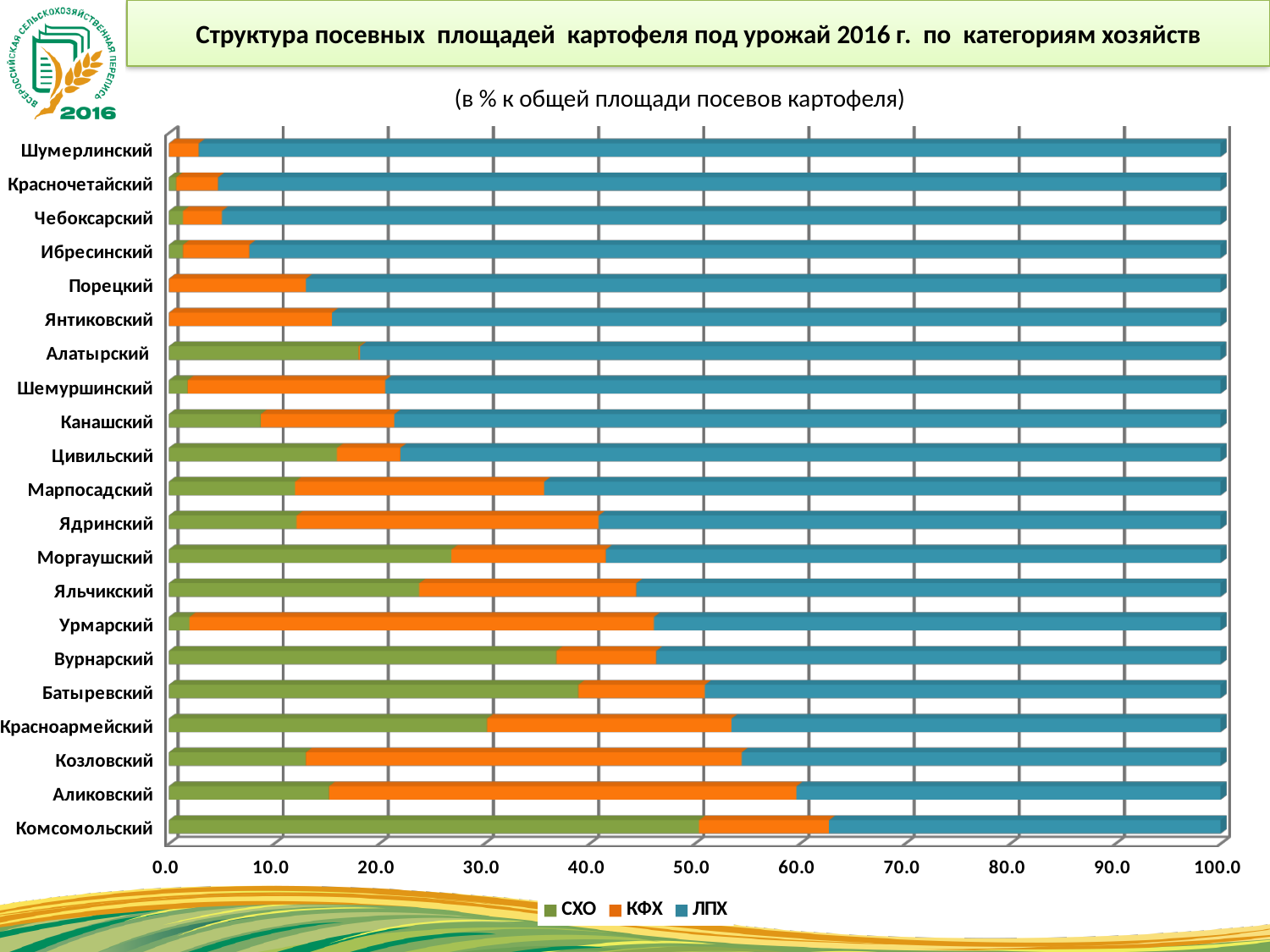
Which district has the largest СХО share? Комсомольский Is the КФХ share for Шумерлинский greater or less than 10.0? less Which district has the larger СХО share, Комсомольский or Батыревский? Комсомольский Which district has the largest ЛПХ share? Шумерлинский How many series does the legend list? 3 Which district has the larger ЛПХ share, Шумерлинский or Аликовский? Шумерлинский How many districts (categories) are plotted on the chart? 21 Which series are listed in the legend? СХО, КФХ, ЛПХ What kind of chart is shown on the slide? Stacked bar chart Is the СХО share for Моргаушский greater or less than 30.0? less Is the СХО share for Комсомольский greater or less than 40.0? greater Which district has the smallest ЛПХ share? Комсомольский